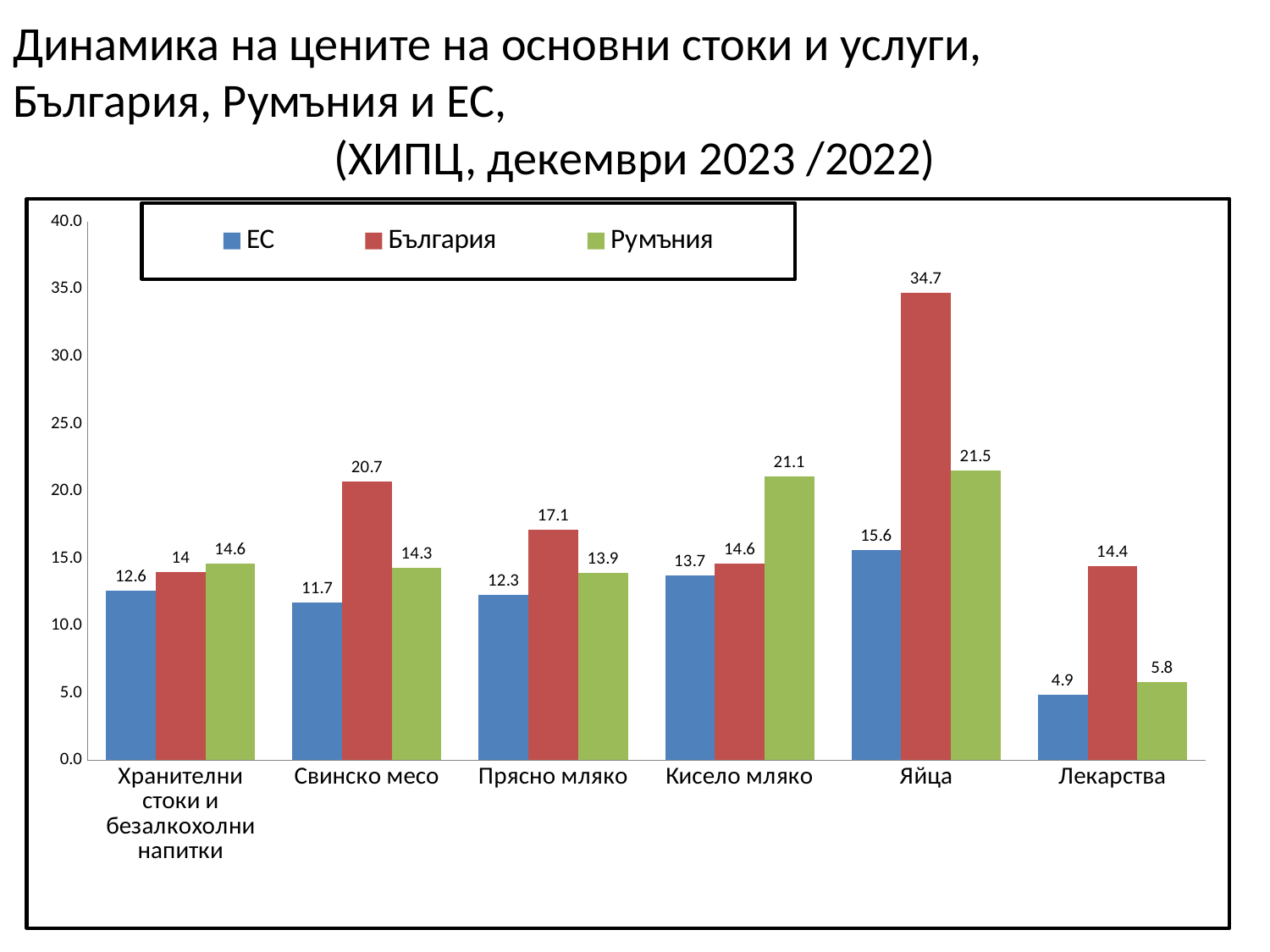
How many categories are shown on the x axis? 6 Which category has the lowest value for Румъния? Лекарства Which colour represents Румъния in the legend? green How many series does the legend list? 3 Is the value for Румъния for Яйца greater or less than 20.0? greater Which category has the highest value for България? Яйца What is the value for Румъния for Кисело мляко? 21.1 Which is larger for Свинско месо: the value for България or the value for Румъния? България What is the value for България for Яйца? 34.7 What is the value for ЕС for Лекарства? 4.9 What is the difference between the България and ЕС values for Яйца? 19.1 What kind of chart is shown on the slide? bar chart